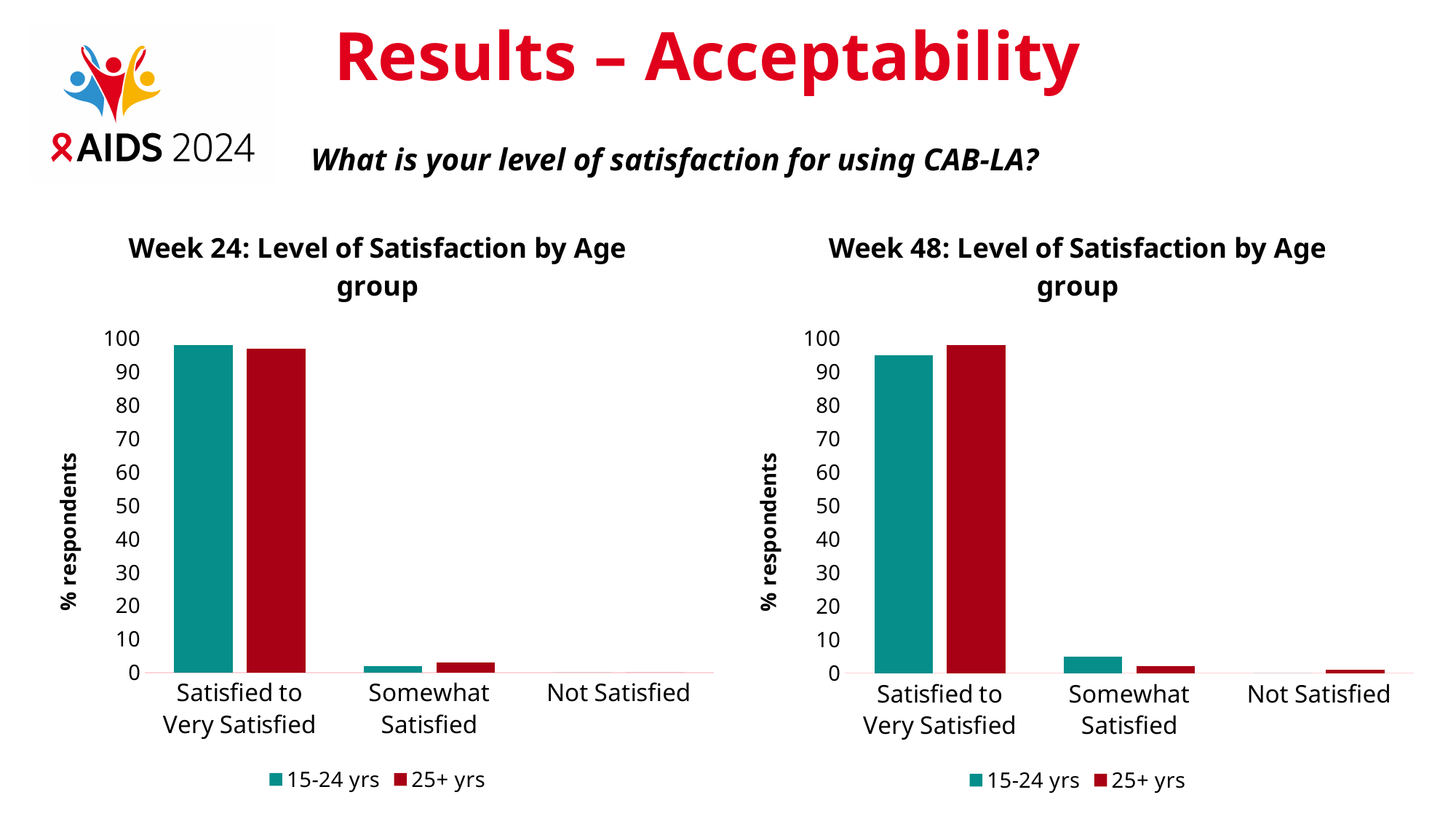
How many satisfaction categories are shown on the x axis of the Week 24: Level of Satisfaction by Age group chart? 3 In the Week 24: Level of Satisfaction by Age group chart, is the value for 15-24 yrs in Satisfied to Very Satisfied greater or less than 90? greater Which colour represents the 25+ yrs series in the Week 48: Level of Satisfaction by Age group chart? red In the Week 48: Level of Satisfaction by Age group chart, is the value for 15-24 yrs in Satisfied to Very Satisfied greater or less than 90? greater In the Week 48: Level of Satisfaction by Age group chart, which category has the lowest value for 15-24 yrs? Not Satisfied In the Week 24: Level of Satisfaction by Age group chart, is the value for 25+ yrs in Somewhat Satisfied greater or less than 10? less What is the y-axis label of the Week 24: Level of Satisfaction by Age group chart? % respondents In the Week 48: Level of Satisfaction by Age group chart, which age group has the larger value for Somewhat Satisfied? 15-24 yrs In the Week 24: Level of Satisfaction by Age group chart, which category has the highest value for 15-24 yrs? Satisfied to Very Satisfied How many series does the legend of the Week 48: Level of Satisfaction by Age group chart list? 2 What kind of chart is the Week 24: Level of Satisfaction by Age group chart? bar chart